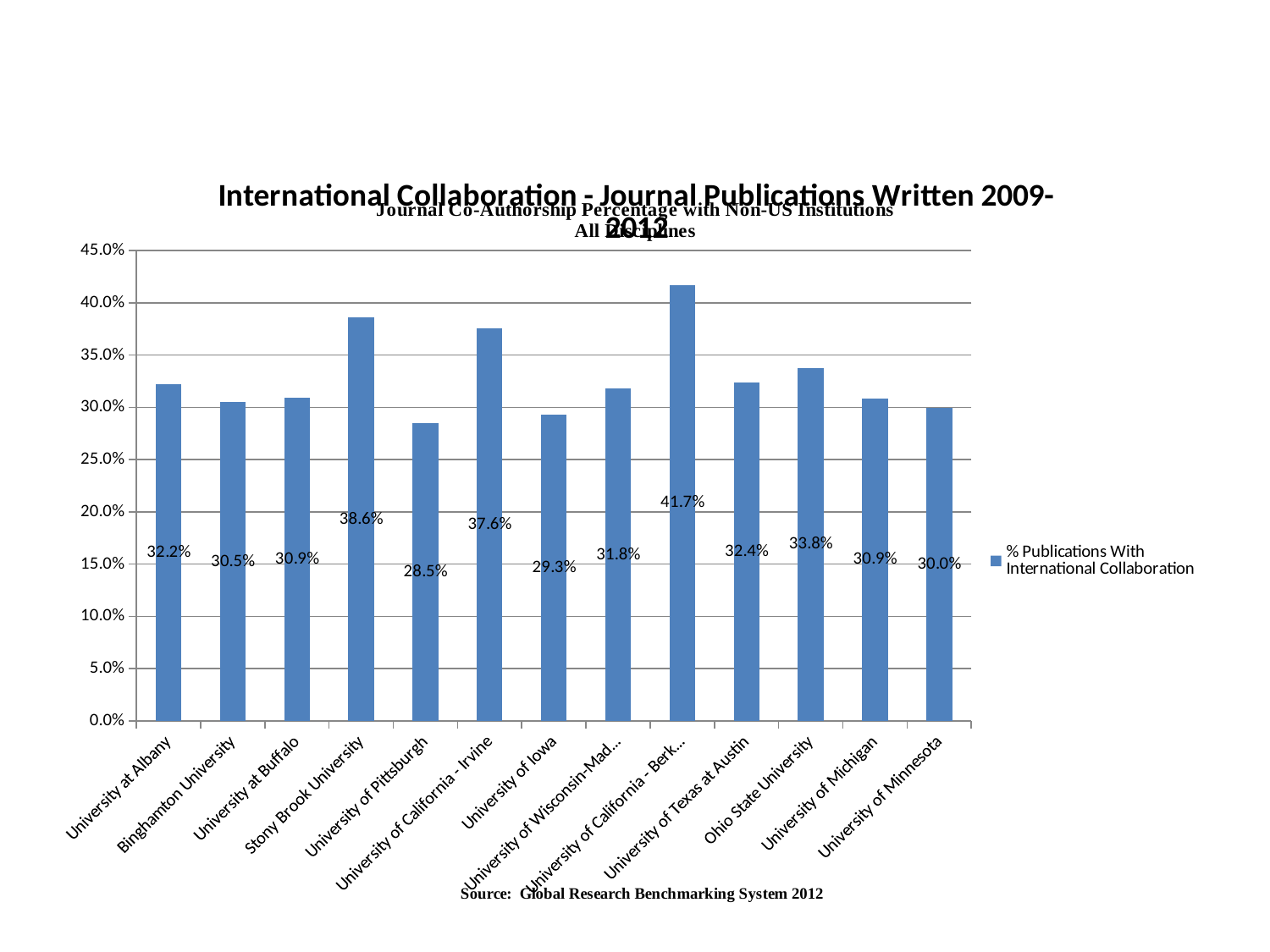
What is the value for University of Minnesota? 30.0% Which university has the lowest percentage of publications with international collaboration? University of Pittsburgh Is the value for University at Albany greater or less than 30.0%? greater What is the difference between the values for Stony Brook University and University of California - Irvine? 1.0% What is the value for Ohio State University? 33.8% What is the value for Stony Brook University? 38.6% Which university has the highest percentage of publications with international collaboration? University of California - Berk... What kind of chart is shown on the slide? Bar chart What is the legend entry for the series shown? % Publications With International Collaboration Which is larger, the value for University of Texas at Austin or the value for University of Iowa? University of Texas at Austin How many universities are shown on the x axis? 13 What is the value for University of Pittsburgh? 28.5%